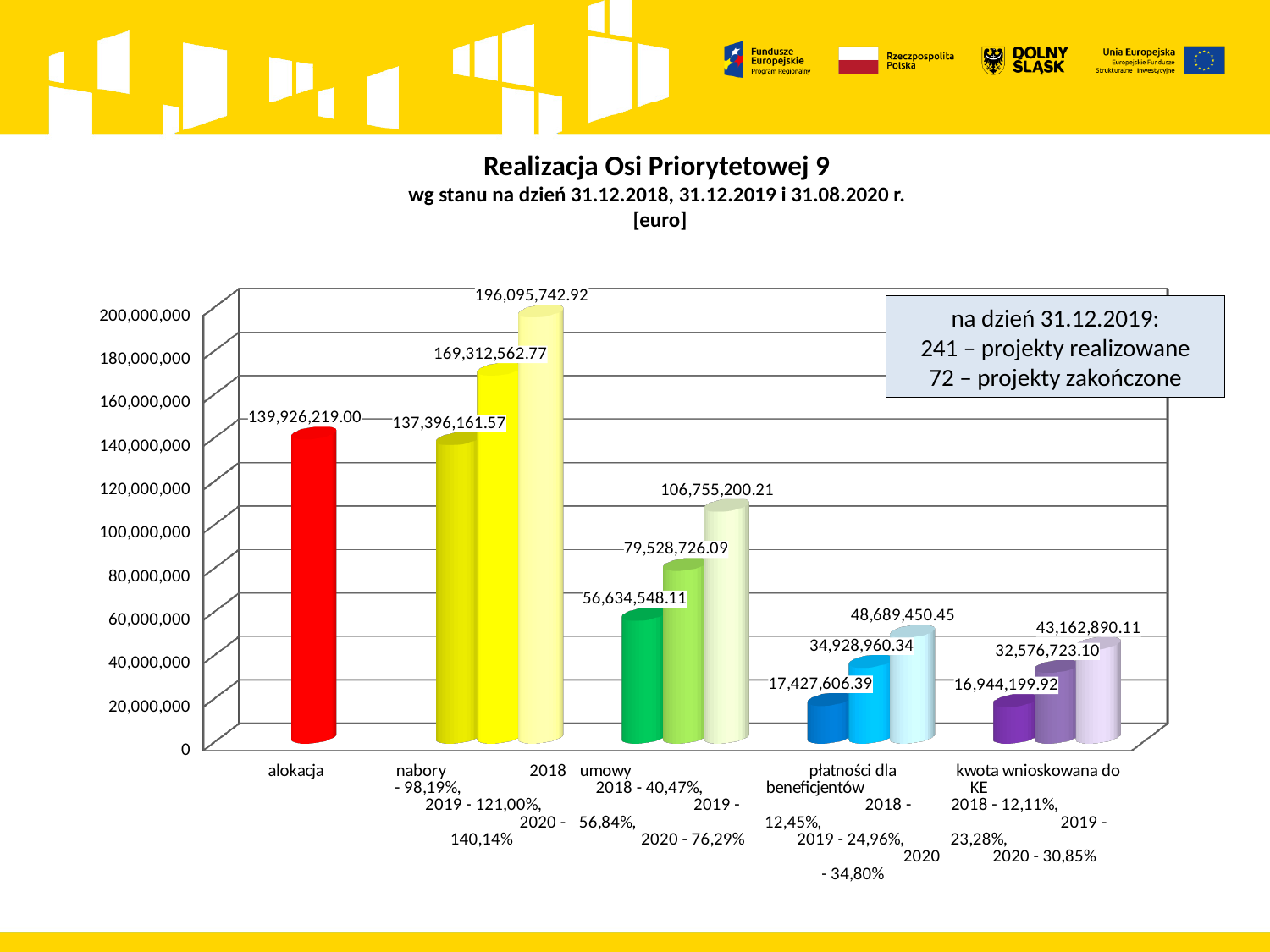
What is the difference between the tallest umowy bar (106,755,200.21) and the shortest umowy bar (56,634,548.11)? 50,120,652.10 What is the highest value shown among the nabory bars? 196,095,742.92 What is the value of the alokacja bar? 139,926,219.00 Which is larger: the tallest płatności dla beneficjentów bar or the tallest kwota wnioskowana do KE bar? the tallest płatności dla beneficjentów bar What kind of chart is shown on the slide? bar chart What is the lowest value shown among the umowy bars? 56,634,548.11 What is the difference between the tallest nabory bar (196,095,742.92) and the alokacja bar (139,926,219.00)? 56,169,523.92 Which category contains the tallest bar on the chart? nabory How many category groups are shown on the x axis? 5 Which category contains the shortest bar on the chart? kwota wnioskowana do KE What is the value of the tallest bar in the płatności dla beneficjentów group? 48,689,450.45 What is the value of the shortest bar in the kwota wnioskowana do KE group? 16,944,199.92